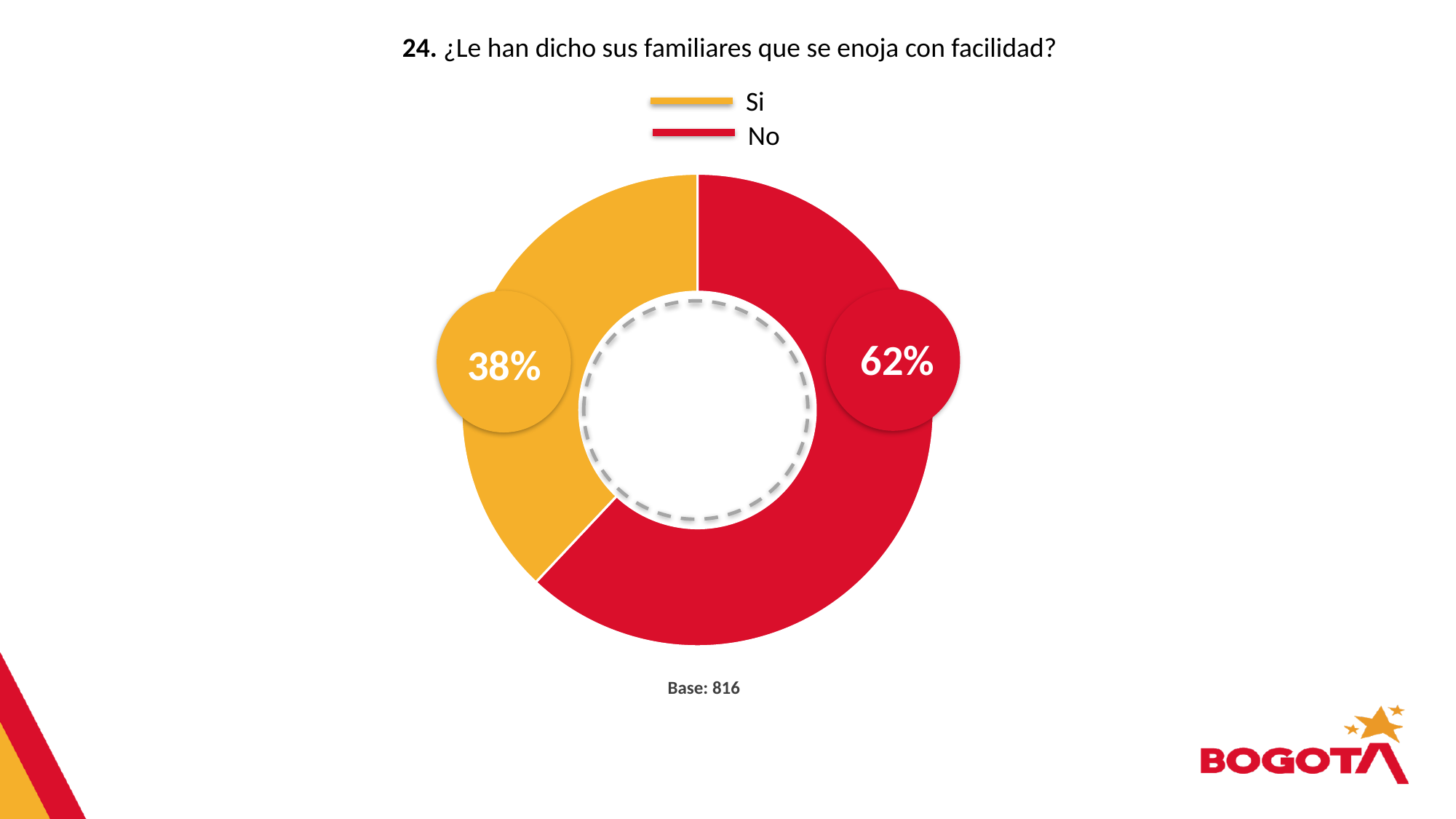
Which response has the smaller share? Si What is the total of the two shares shown in the chart? 100% What is the difference in percentage points between the "No" and "Si" shares? 24 Which response has the larger share, "Si" or "No"? No What percentage of respondents answered "No"? 62% Which colour represents the "No" response in the chart? Red What kind of chart is shown on the slide? Doughnut (pie) chart How many entries does the legend list? 2 What is the base (number of respondents) shown below the chart? 816 What percentage of respondents answered "Si"? 38% How many categories are shown in the chart? 2 Is the share for "Si" larger or smaller than the share for "No"? smaller